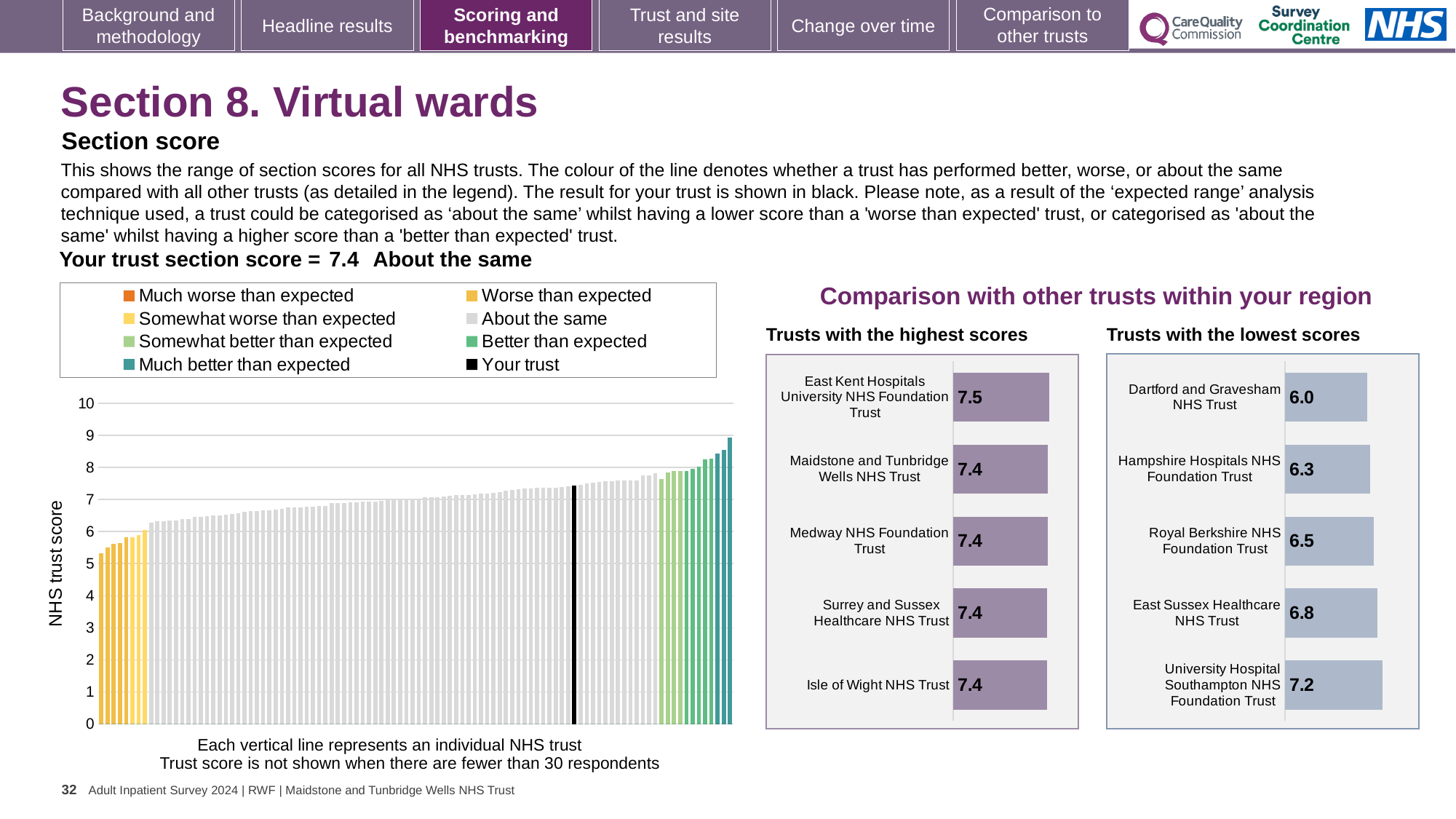
In the 'Trusts with the highest scores' chart, what is the difference between the scores of East Kent Hospitals University NHS Foundation Trust and Isle of Wight NHS Trust? 0.1 In the 'Trusts with the lowest scores' chart, how much higher is University Hospital Southampton NHS Foundation Trust's score than Dartford and Gravesham NHS Trust's score? 1.2 In the 'Trusts with the lowest scores' chart, which trust has the lowest score? Dartford and Gravesham NHS Trust In the main NHS trust score chart on the left, is the value of the tallest bar greater or less than 8? greater What kind of chart is the main NHS trust score chart on the left of the slide? Bar chart In the 'Trusts with the highest scores' chart, what is the score for East Kent Hospitals University NHS Foundation Trust? 7.5 How many entries does the legend of the main NHS trust score chart on the left list? 8 How many trusts are shown in the 'Trusts with the highest scores' chart? 5 In the 'Trusts with the lowest scores' chart, what is the score for Hampshire Hospitals NHS Foundation Trust? 6.3 In the 'Trusts with the lowest scores' chart, which has the larger score: Royal Berkshire NHS Foundation Trust or East Sussex Healthcare NHS Trust? East Sussex Healthcare NHS Trust In the 'Trusts with the lowest scores' chart, which trust has the highest score? University Hospital Southampton NHS Foundation Trust In the main NHS trust score chart on the left, do the values rise or fall from left to right? Rise